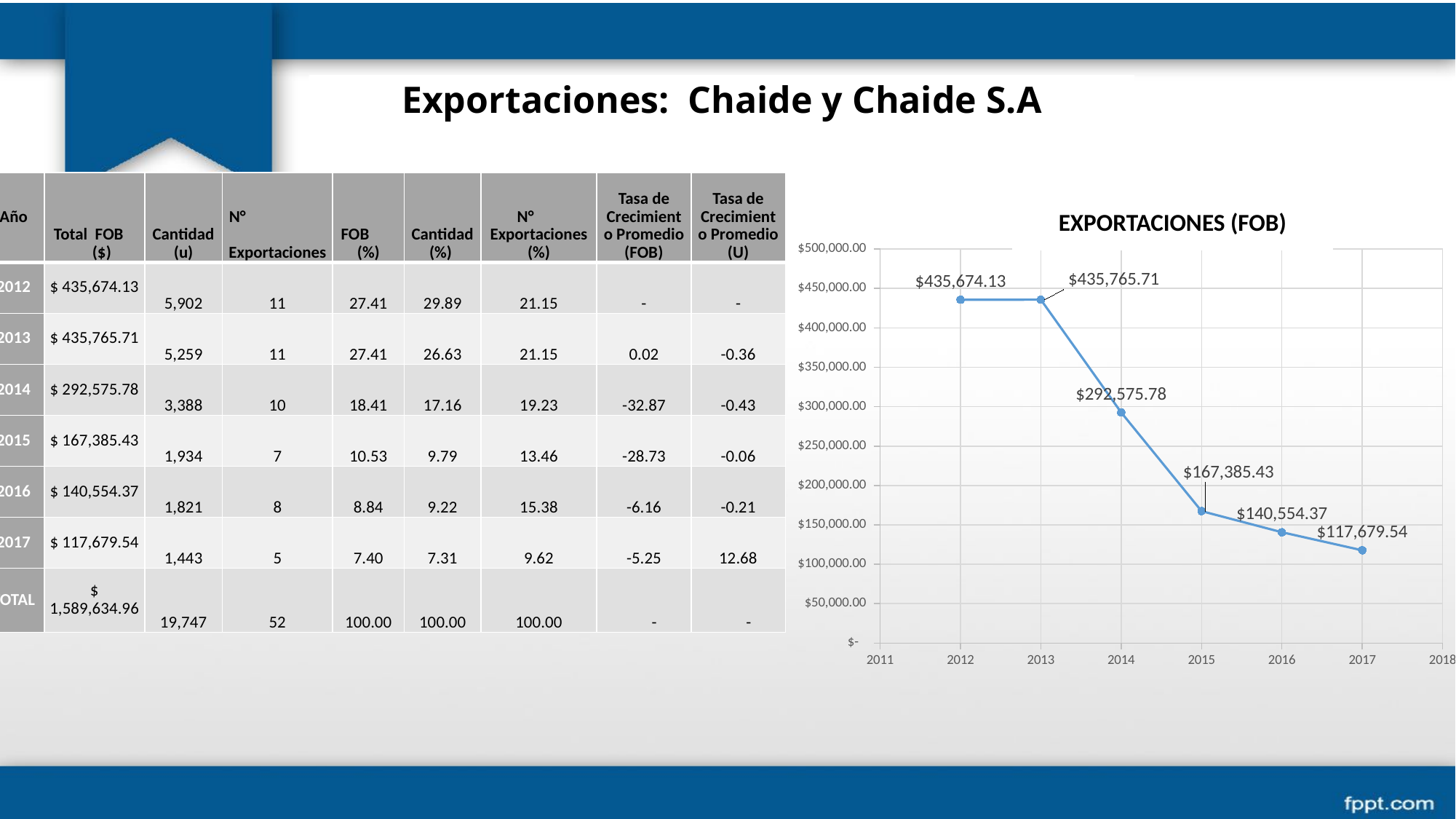
Which year has the lowest value in the EXPORTACIONES (FOB) chart? 2017 How many data points are plotted in the EXPORTACIONES (FOB) chart? 6 In the EXPORTACIONES (FOB) chart, is the value for 2014 greater or less than $250,000.00? greater What kind of chart is the EXPORTACIONES (FOB) chart? line chart In the EXPORTACIONES (FOB) chart, what is the difference between the values for 2014 and 2015? $125,190.35 In the EXPORTACIONES (FOB) chart, what is the difference between the values for 2012 and 2017? $317,994.59 What is the title of the chart on the slide? EXPORTACIONES (FOB) What is the value for 2017 in the EXPORTACIONES (FOB) chart? $117,679.54 Do the values in the EXPORTACIONES (FOB) chart generally rise or fall from 2013 to 2017? fall What is the value for 2012 in the EXPORTACIONES (FOB) chart? $435,674.13 In the EXPORTACIONES (FOB) chart, which is larger, the value for 2015 or the value for 2016? 2015 What is the value for 2014 in the EXPORTACIONES (FOB) chart? $292,575.78